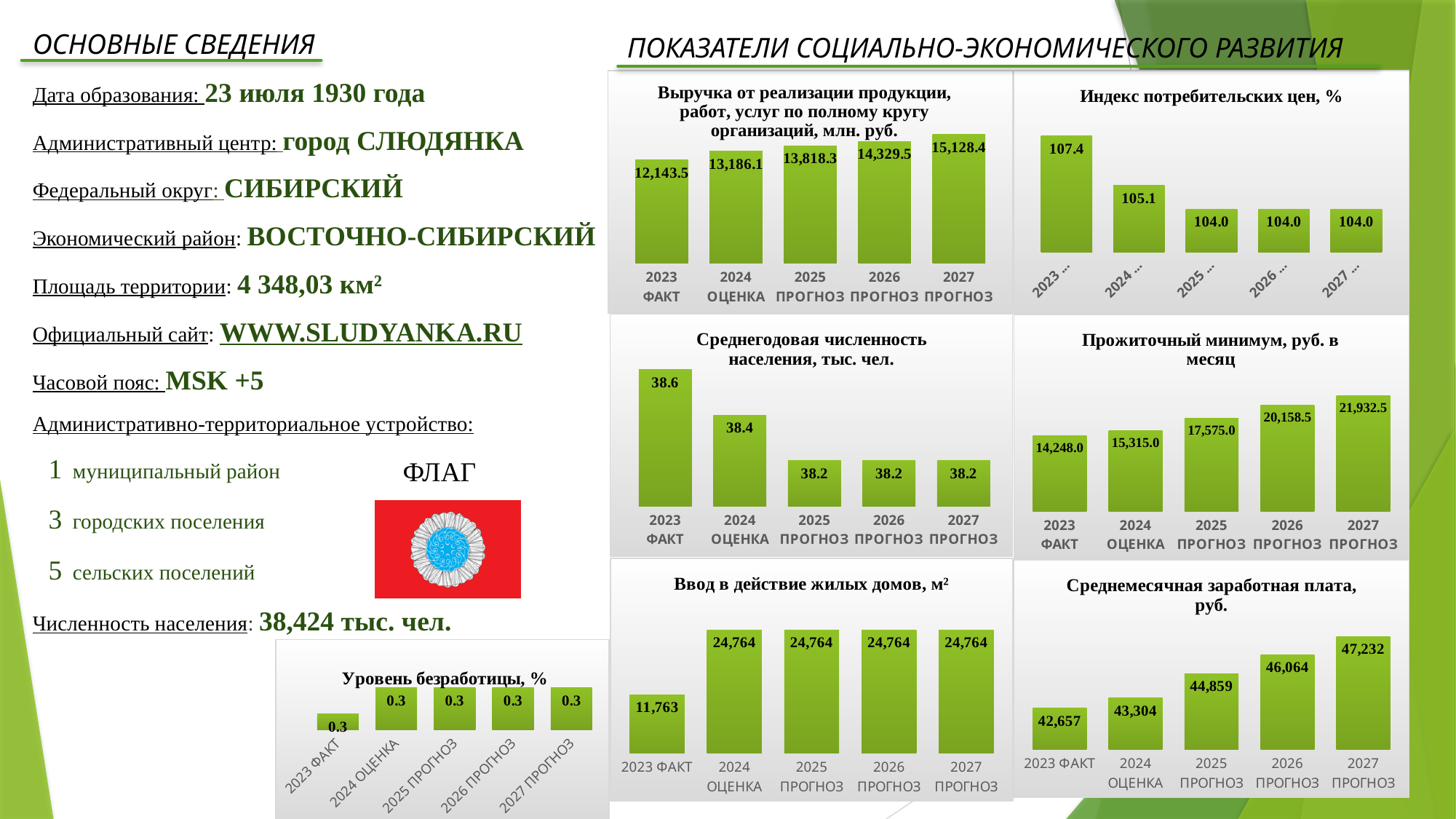
In the chart titled "Уровень безработицы, %", how many bars are plotted? 5 In the chart titled "Среднегодовая численность населения, тыс. чел.", which is larger: the value for 2023 ФАКТ or the value for 2025 ПРОГНОЗ? 2023 ФАКТ In the chart titled "Выручка от реализации продукции, работ, услуг по полному кругу организаций, млн. руб.", what is the difference between the 2024 ОЦЕНКА value and the 2023 ФАКТ value? 1,042.6 In the chart titled "Среднемесячная заработная плата, руб.", do the values rise or fall from 2023 to 2027? rise In the chart titled "Прожиточный минимум, руб. в месяц", what is the difference between the 2027 ПРОГНОЗ value and the 2023 ФАКТ value? 7,684.5 What kind of chart is the one titled "Прожиточный минимум, руб. в месяц"? bar chart In the chart titled "Ввод в действие жилых домов, м²", what is the value for 2023 ФАКТ? 11,763 In the chart titled "Среднегодовая численность населения, тыс. чел.", what is the value for 2024 ОЦЕНКА? 38.4 In the chart titled "Среднемесячная заработная плата, руб.", which year has the lowest value? 2023 ФАКТ In the chart titled "Индекс потребительских цен, %", which year has the highest value? 2023 In the chart titled "Выручка от реализации продукции, работ, услуг по полному кругу организаций, млн. руб.", what is the value for 2027 ПРОГНОЗ? 15,128.4 In the chart titled "Индекс потребительских цен, %", what is the value for 2024? 105.1